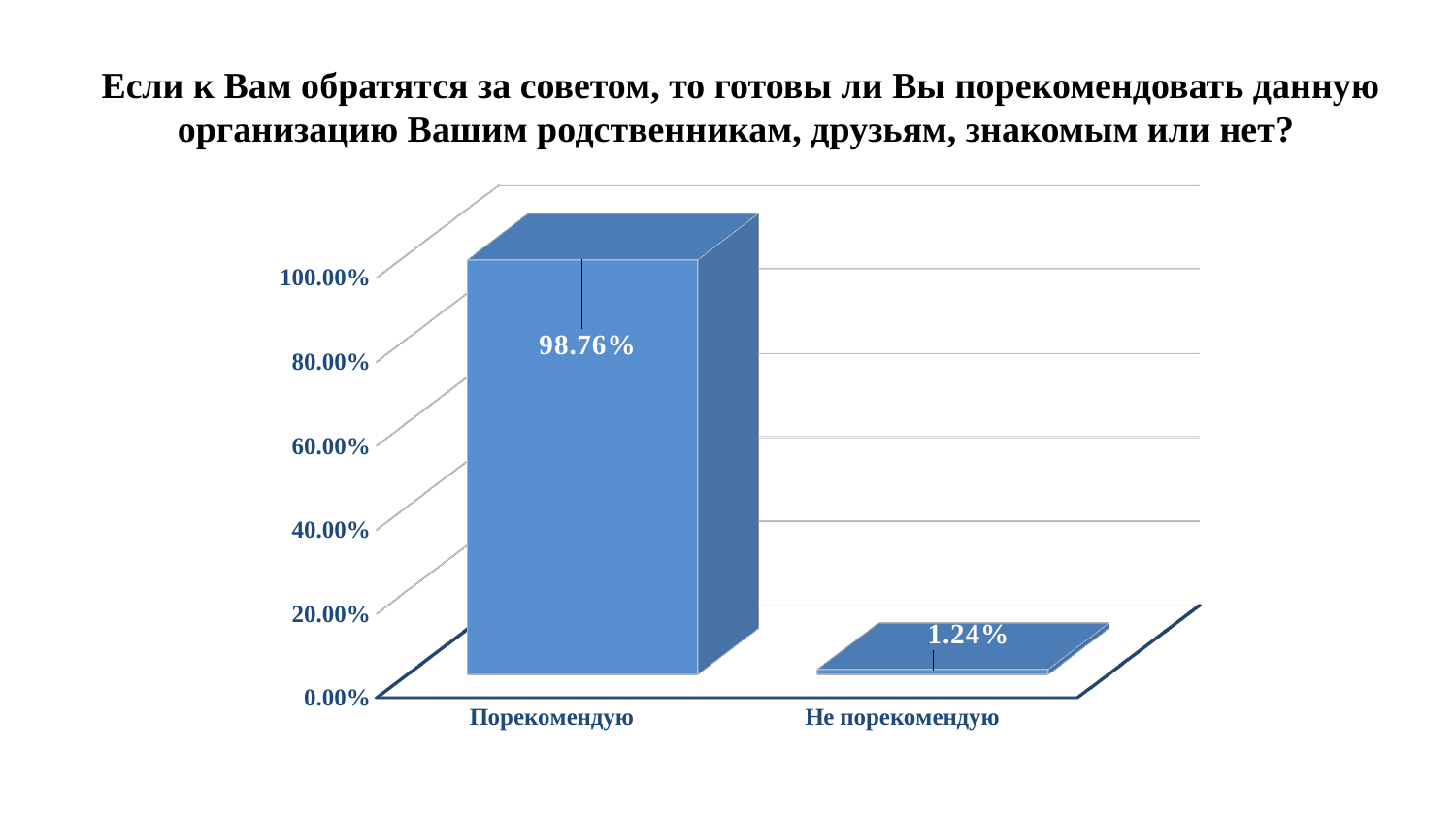
Which category has the lowest value? Не порекомендую What is the total of the two values shown in the chart? 100.00% Which is larger, the value for "Порекомендую" or for "Не порекомендую"? Порекомендую What is the difference between the values for "Порекомендую" and "Не порекомендую"? 97.52% What is the value for "Не порекомендую"? 1.24% What is the highest value shown on the vertical axis? 100.00% How many categories are shown on the x axis? 2 Is the value for "Порекомендую" greater or less than 80.00%? greater Which category has the highest value? Порекомендую What kind of chart is shown on the slide? bar chart Is the value for "Не порекомендую" greater or less than 20.00%? less What is the value for "Порекомендую"? 98.76%